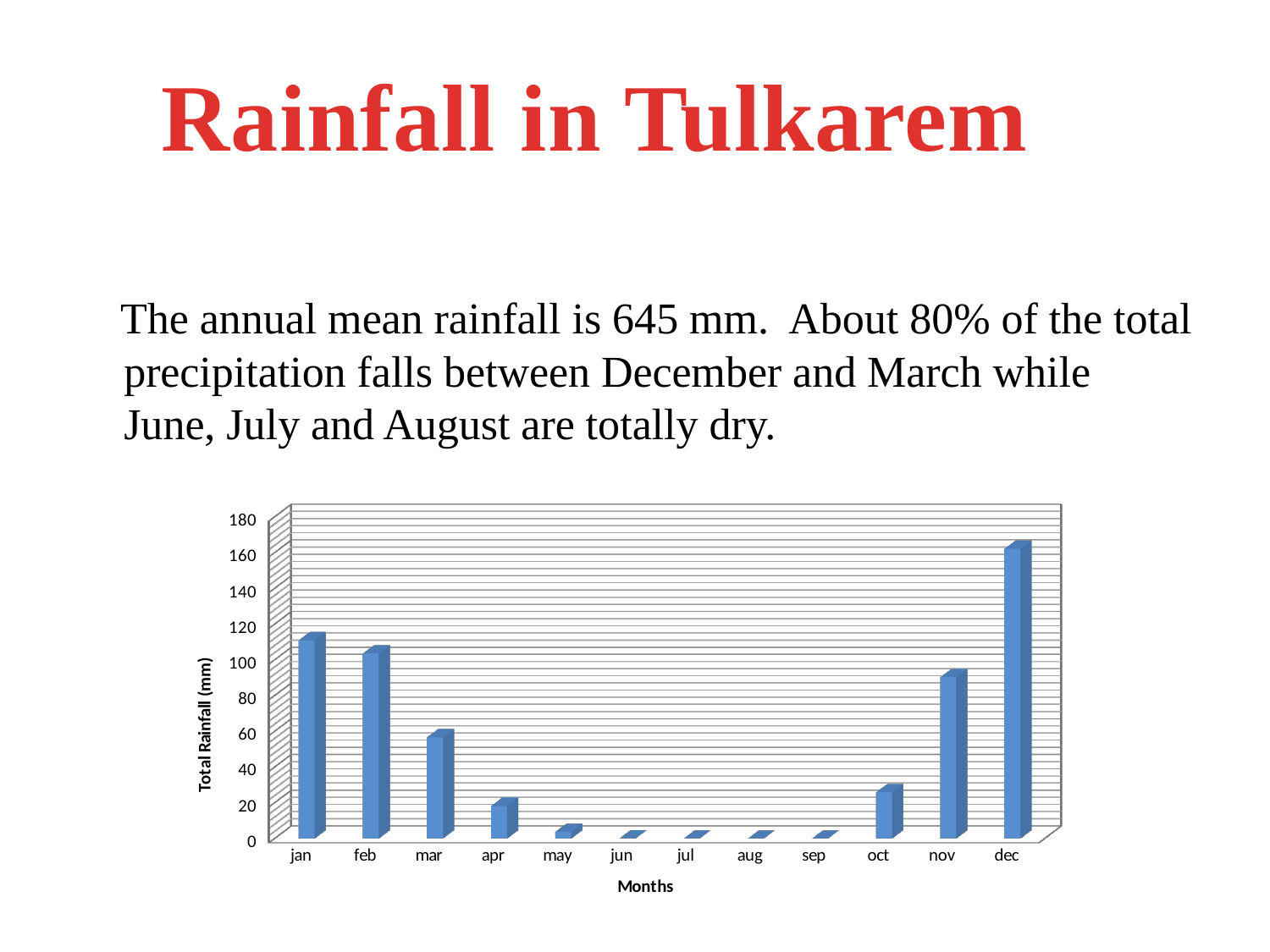
Is the value for mar greater or less than 40? greater Is the value for dec greater or less than 140? greater How many months are shown on the x axis of the chart? 12 What is the label on the vertical axis of the chart? Total Rainfall (mm) Which month has the highest total rainfall in the chart? dec Is the value for jan greater or less than 100? greater Do the values rise or fall from jan to may? fall Which has the larger value, jan or mar? jan What kind of chart is shown on the slide? bar chart Which has the larger value, oct or nov? nov